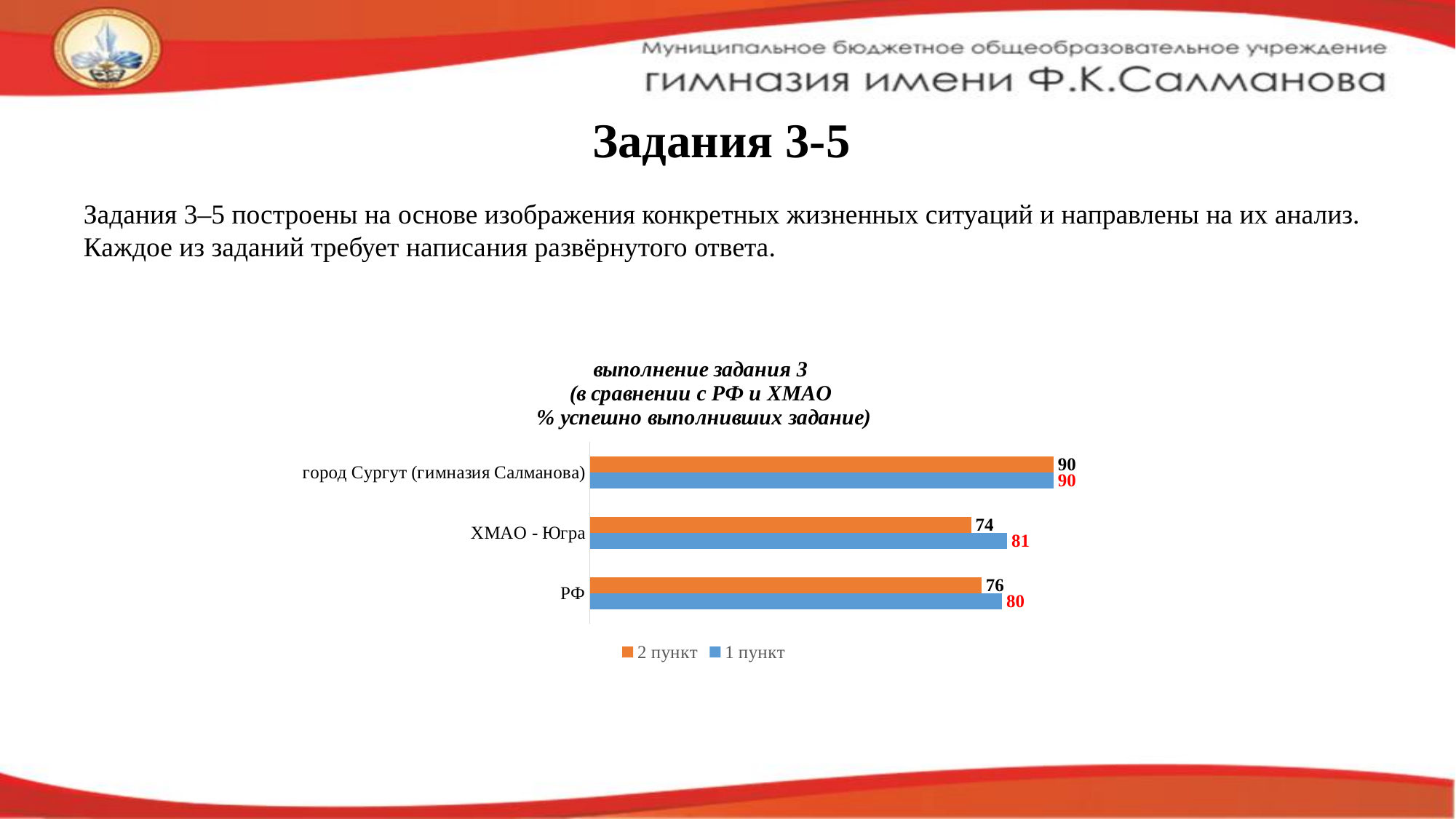
Which category has the lowest value for "2 пункт"? ХМАО - Югра What kind of chart is shown on the slide? bar chart What is the value of "2 пункт" for РФ? 76 How many series does the legend list? 2 Which category has the highest value for "2 пункт"? город Сургут (гимназия Салманова) What is the value of "2 пункт" for город Сургут (гимназия Салманова)? 90 What is the difference between the "1 пункт" and "2 пункт" values for ХМАО - Югра? 7 What is the value of "1 пункт" for ХМАО - Югра? 81 Which is larger for РФ: "1 пункт" or "2 пункт"? 1 пункт How many categories are shown on the chart? 3 What is the value of "1 пункт" for РФ? 80 What colour are the bars for the "2 пункт" series? orange